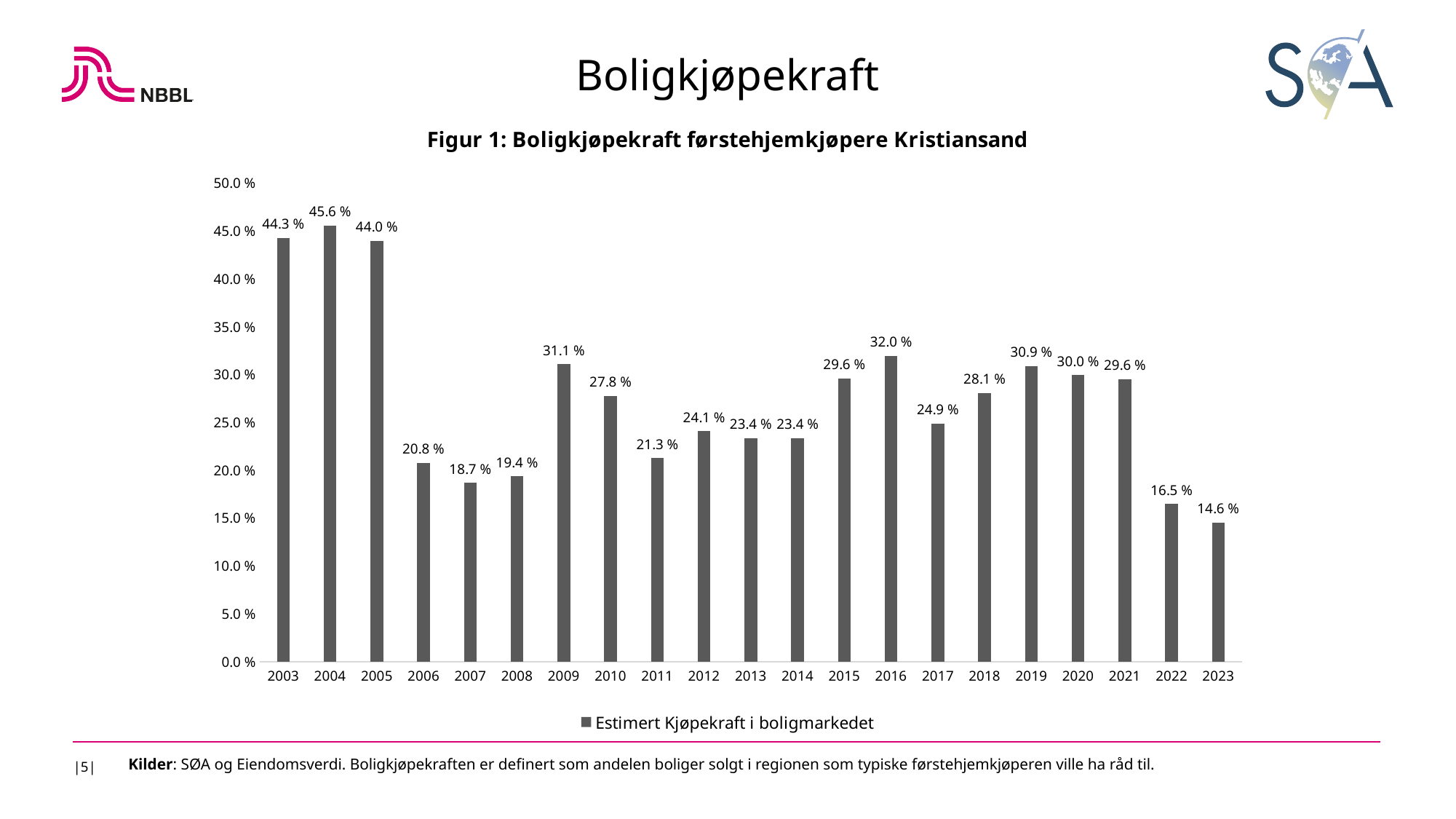
What is the legend entry for the series? Estimert Kjøpekraft i boligmarkedet What is the value for 2023? 14.6 % What is the difference between the values for 2003 and 2023? 29.7 % What is the value for 2016? 32.0 % What kind of chart is shown? bar chart Is the value for 2007 greater or less than 20.0 %? less How many series does the legend list? 1 Which year has the highest value? 2004 Which year has the lowest value? 2023 How many years are shown on the x axis? 21 What is the value for 2004? 45.6 % Which is larger, the value for 2009 or the value for 2010? 2009